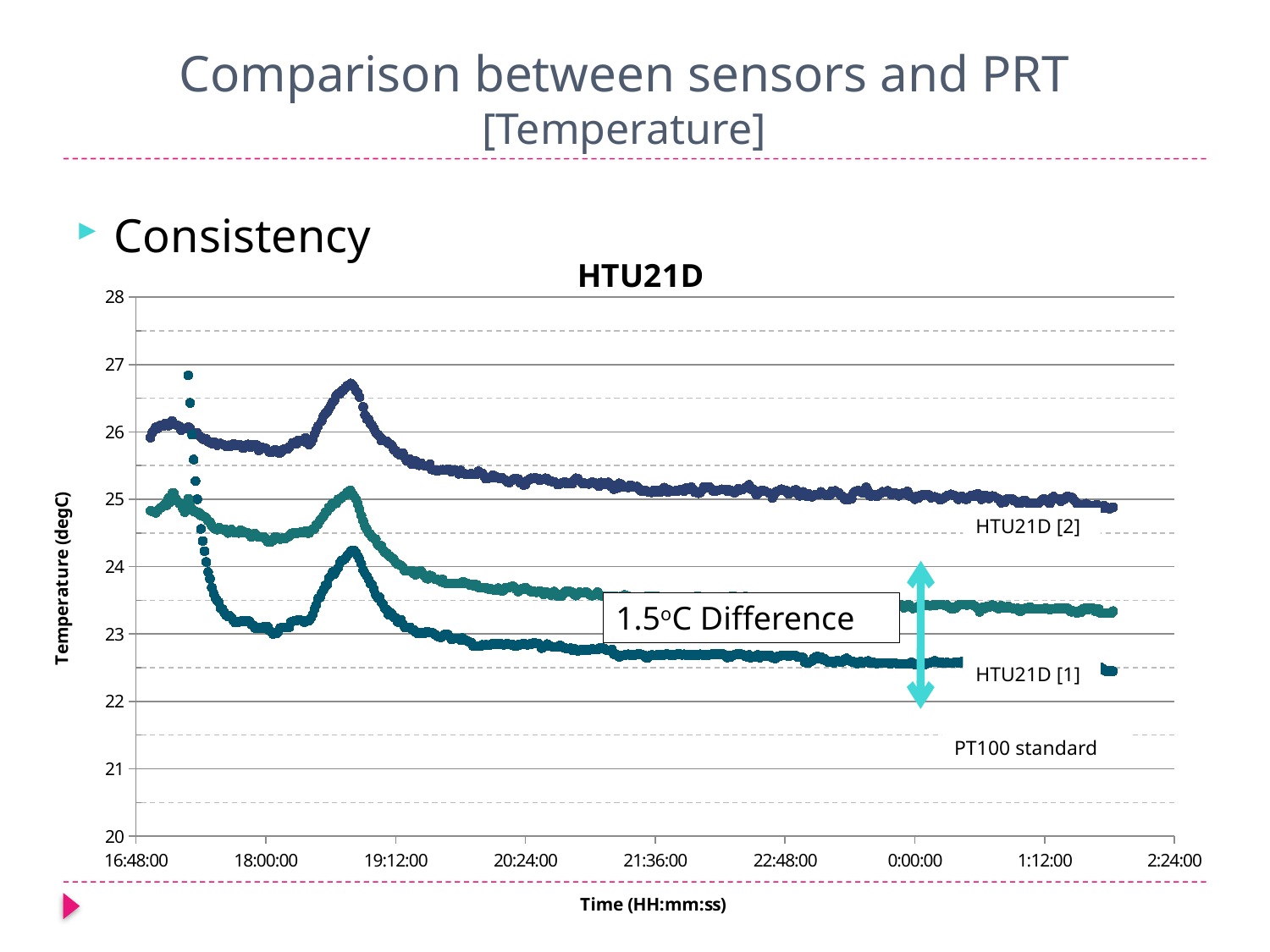
What is the label of the y axis? Temperature (degC) Which labelled series has the highest temperature values on the chart? HTU21D [2] Does the HTU21D [2] series rise or fall between 20:24:00 and 1:12:00? fall Is the peak value of HTU21D [2] near 18:48 greater or less than 26? greater What is the title of the chart? HTU21D Is the value for HTU21D [1] at 0:00:00 greater or less than 23? greater Which labelled series has the lowest temperature values on the chart? PT100 standard Which series has higher temperature values, HTU21D [2] or HTU21D [1]? HTU21D [2] Is the value for HTU21D [2] at 0:00:00 greater or less than 24? greater How many data series are labelled on the chart? 3 What kind of chart is shown on the slide? scatter chart What temperature difference is annotated between the HTU21D [2] and HTU21D [1] series? 1.5°C